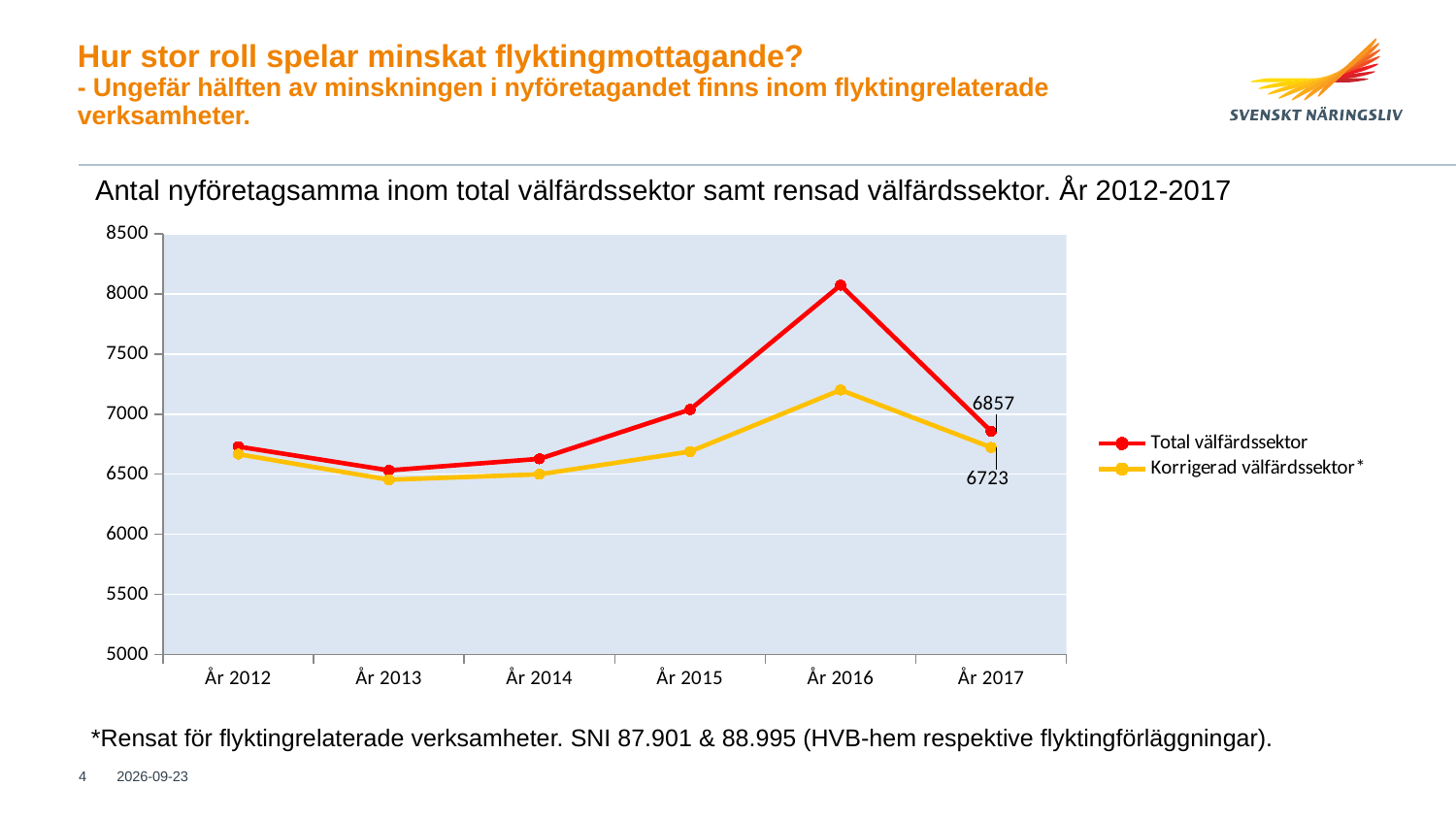
What is the difference between Total välfärdssektor and Korrigerad välfärdssektor* in År 2017? 134 What type of chart is shown on the slide? line chart Does Total välfärdssektor rise or fall from År 2016 to År 2017? fall Which series has the larger value in År 2016, Total välfärdssektor or Korrigerad välfärdssektor*? Total välfärdssektor What is the value for Total välfärdssektor in År 2017? 6857 Is the value for Korrigerad välfärdssektor* in År 2016 greater or less than 7000? greater How many series does the legend list? 2 What is the value for Korrigerad välfärdssektor* in År 2017? 6723 In which year is Total välfärdssektor lowest? År 2013 In which year is Total välfärdssektor highest? År 2016 How many years are plotted on the x axis? 6 In which year is Korrigerad välfärdssektor* highest? År 2016